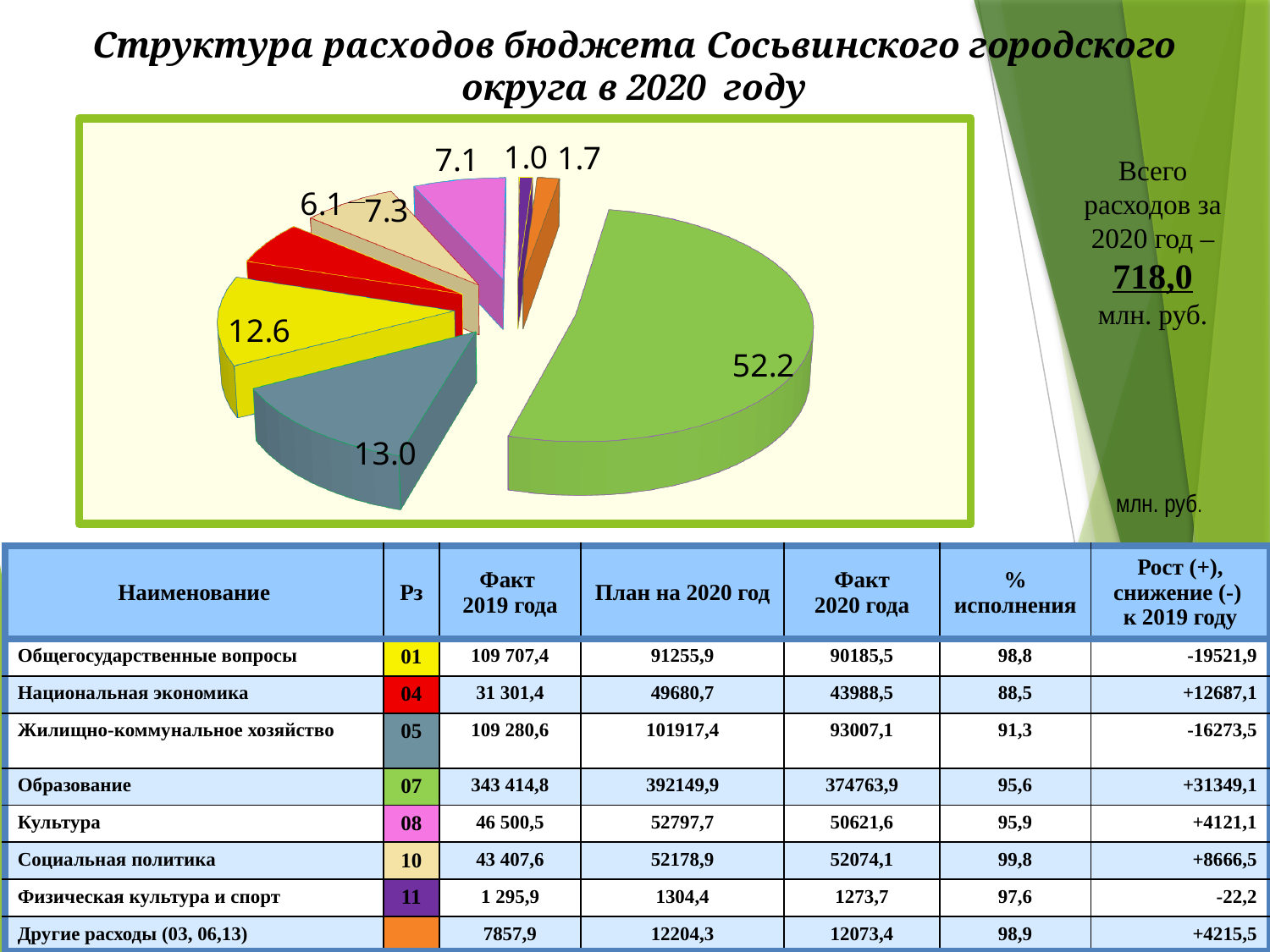
What value is shown for the grey-blue slice (Жилищно-коммунальное хозяйство) in the pie chart? 13.0 What is the title of the slide containing the pie chart? Структура расходов бюджета Сосьвинского городского округа в 2020 году What value is shown for the pink slice (Культура) in the pie chart? 7.1 What value is shown for the yellow slice (Общегосударственные вопросы) in the pie chart? 12.6 What is the value of the smallest slice of the pie chart? 1.0 What is the difference between the grey-blue slice (13.0) and the yellow slice (12.6) in the pie chart? 0.4 What value is shown for the green slice (Образование) in the pie chart? 52.2 What total expenditure for 2020 is stated next to the pie chart? 718,0 млн. руб. What kind of chart is shown on the slide? Pie chart How many slices does the pie chart have? 8 What is the value of the largest slice of the pie chart? 52.2 Which is larger in the pie chart: the beige slice (Социальная политика) or the red slice (Национальная экономика)? Beige slice (Социальная политика), 7.3